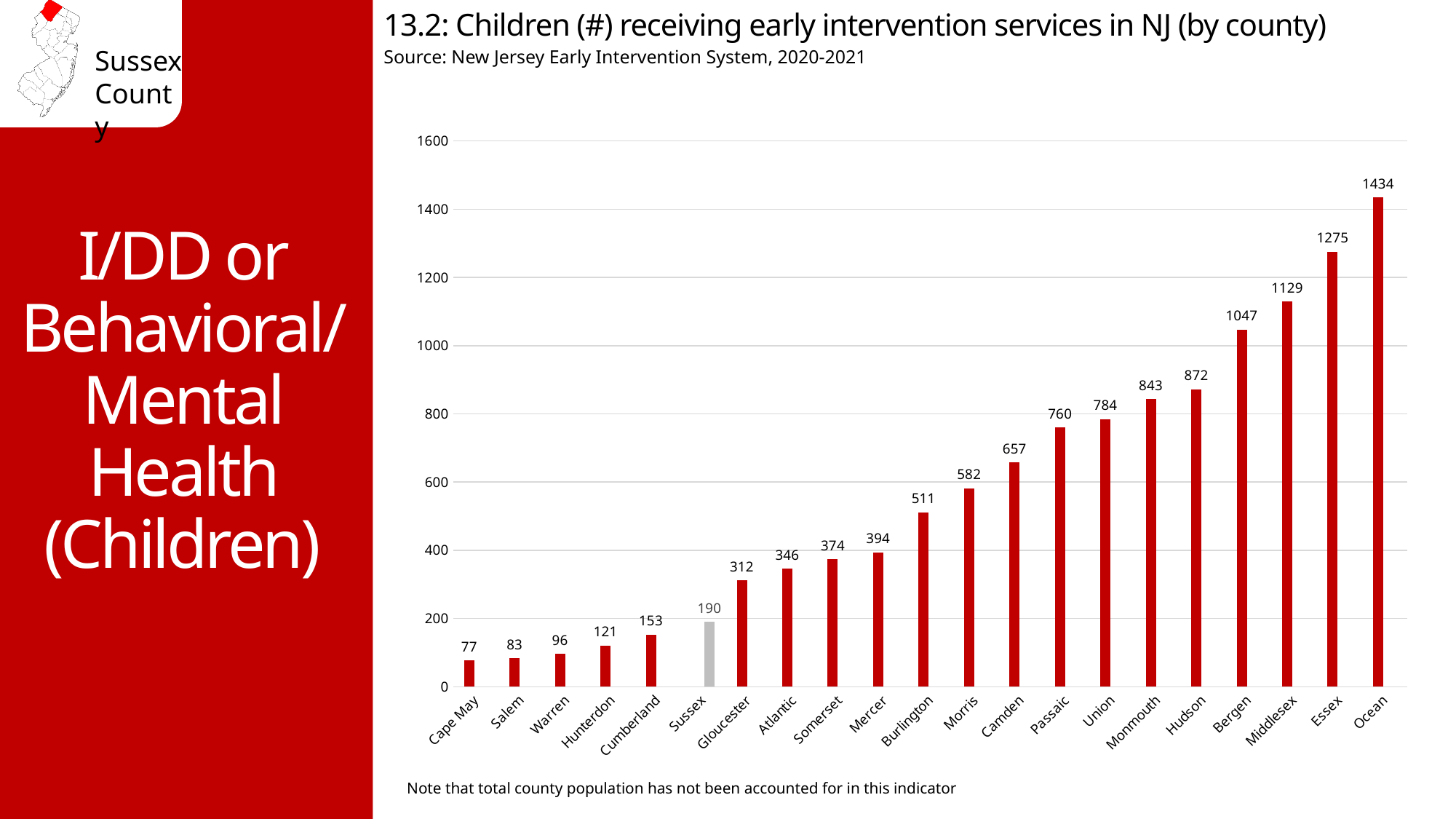
What is the value shown for Bergen County? 1047 What is the difference between the values for Sussex and Cumberland? 37 Which county has the highest number of children receiving early intervention services? Ocean What type of chart is used on this slide? Bar chart What is the difference between the values for Ocean and Essex? 159 How many counties are shown on the chart? 21 How many children received early intervention services in Sussex County? 190 Which county has the lowest number of children receiving early intervention services? Cape May Do the values rise or fall moving from left to right along the x axis? Rise Which county has a larger value, Morris or Camden? Camden Which county's bar is shown in gray rather than red? Sussex Is the value for Middlesex greater or less than 1000? greater